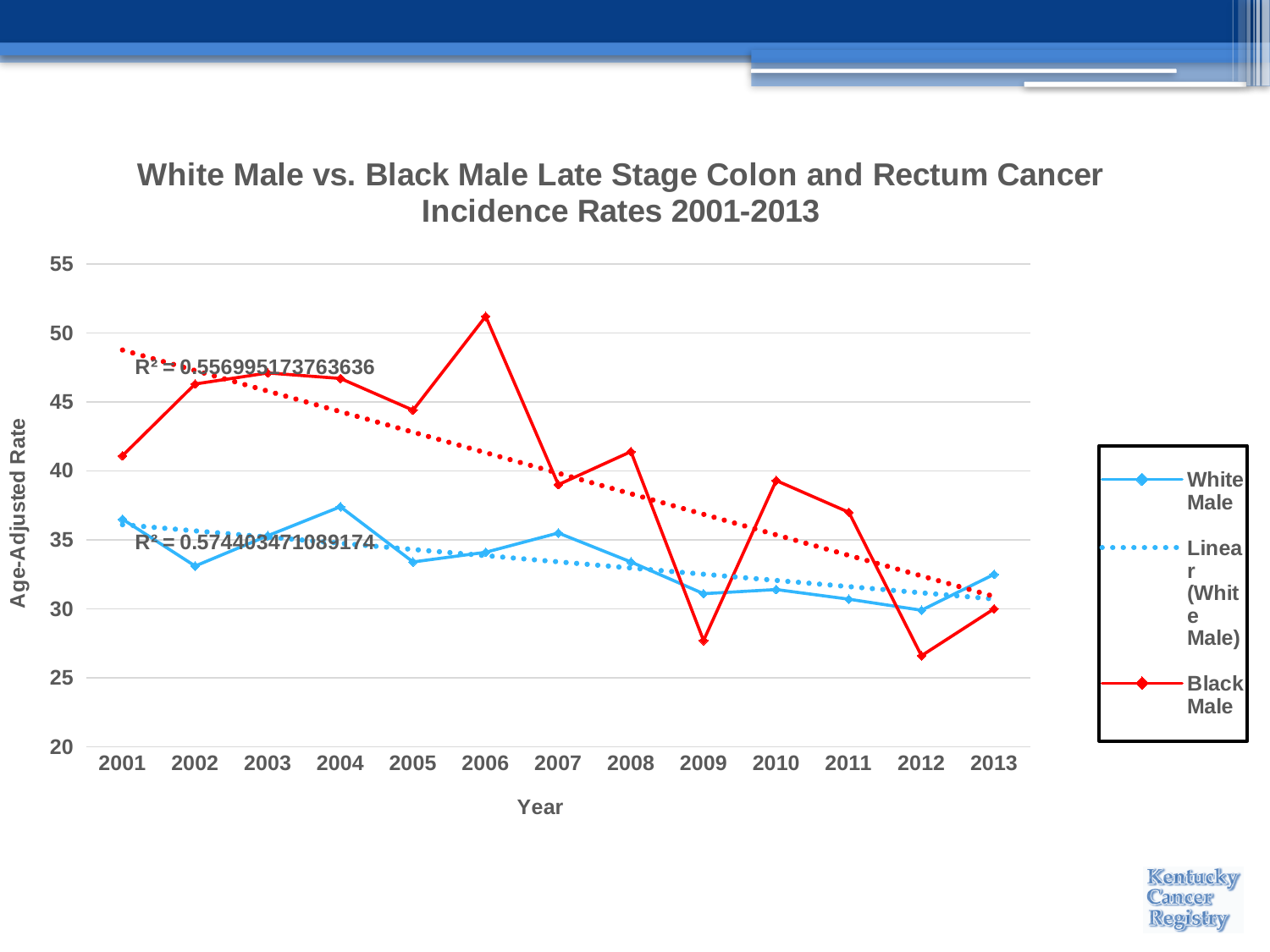
How many years are plotted along the x axis? 13 What is the label on the vertical axis? Age-Adjusted Rate Is the White Male value for 2002 greater or less than 35? less Is the Black Male value for 2012 greater or less than 30? less Is the Black Male value for 2006 greater or less than 50? greater What kind of chart is shown on the slide? Line chart In which year does the Black Male series reach its lowest value? 2012 How many entries does the legend list? 3 In which year does the Black Male series reach its highest value? 2006 In 2009, which series has the higher value, White Male or Black Male? White Male In which year does the White Male series reach its highest value? 2004 Overall, do the Black Male values rise or fall from 2001 to 2013? Fall